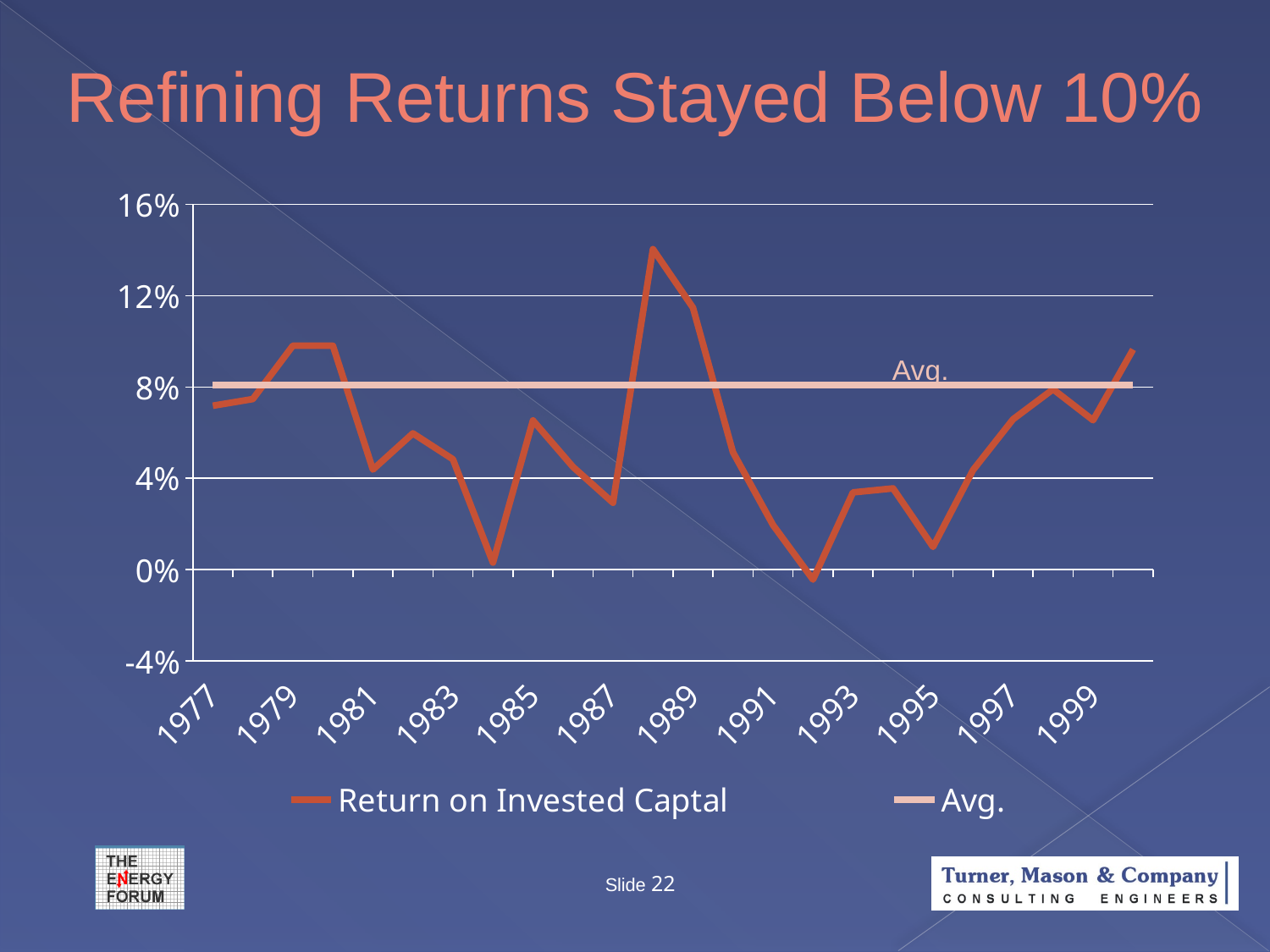
Which year has the larger Return on Invested Captal, 1981 or 1985? 1985 In which labeled year does Return on Invested Captal reach its highest value? 1989 What is the title of the chart on the slide? Refining Returns Stayed Below 10% Is the Return on Invested Captal value for 1989 greater or less than 12%? less Is the Return on Invested Captal value for 1995 greater or less than 4%? less Is the Return on Invested Captal value for 1997 greater or less than 4%? greater What kind of chart is shown on the slide? line chart Does Return on Invested Captal rise or fall from 1989 to 1991? fall What are the two series named in the legend? Return on Invested Captal and Avg. How many series does the legend list? 2